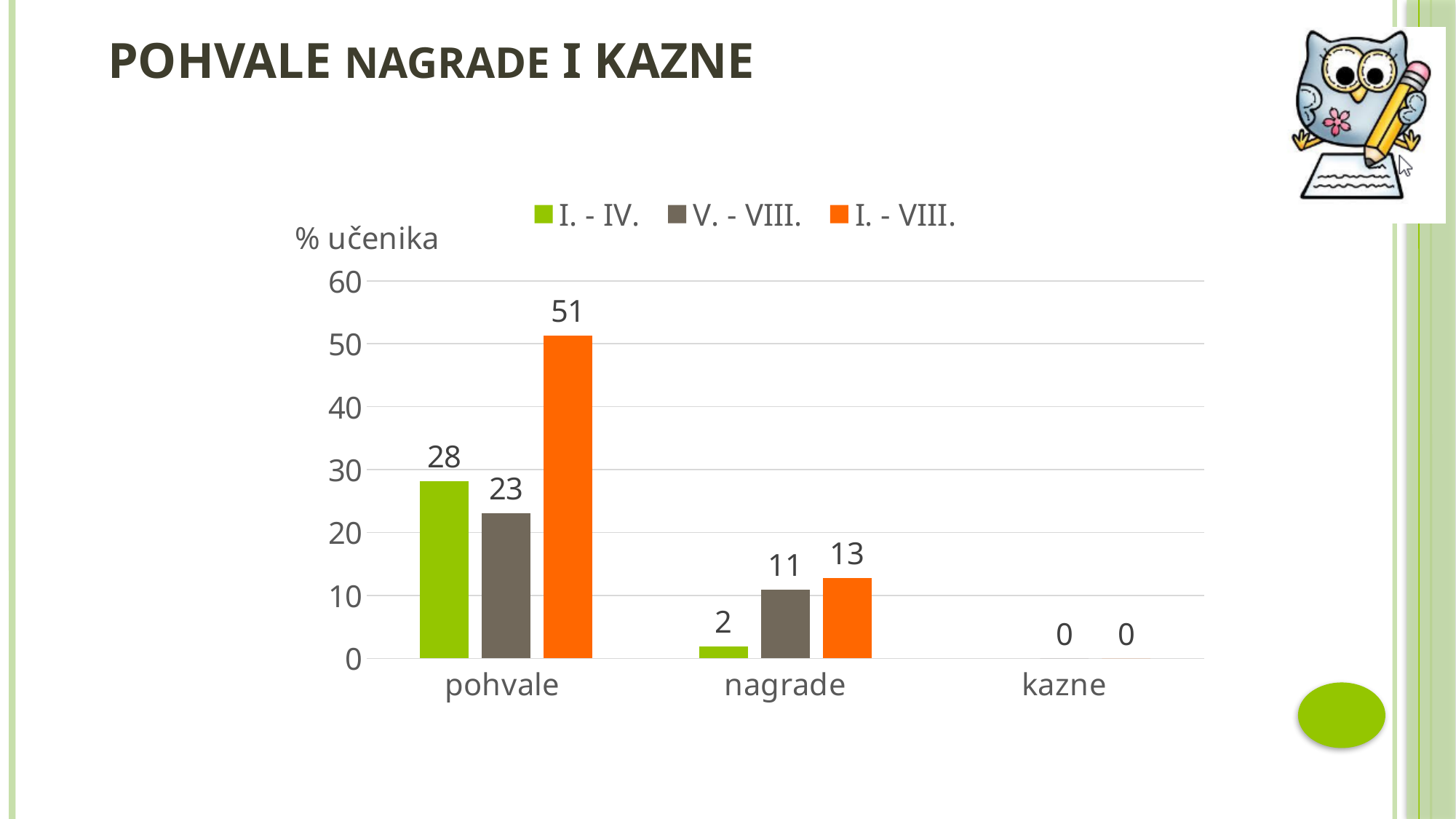
How many series does the legend list? 3 What is the value for I. - IV. in the nagrade category? 2 What is the value for I. - VIII. in the pohvale category? 51 Which category has the highest value for the I. - VIII. series? pohvale Is the value for I. - VIII. in the pohvale category greater or less than 50? greater What is the value for I. - IV. in the pohvale category? 28 What is the label of the vertical axis? % učenika What is the value for V. - VIII. in the nagrade category? 11 How many categories are shown on the x axis? 3 What kind of chart is shown on the slide? bar chart What is the difference between the I. - IV. and V. - VIII. values in the pohvale category? 5 Which is larger in the nagrade category, the V. - VIII. value or the I. - VIII. value? I. - VIII.